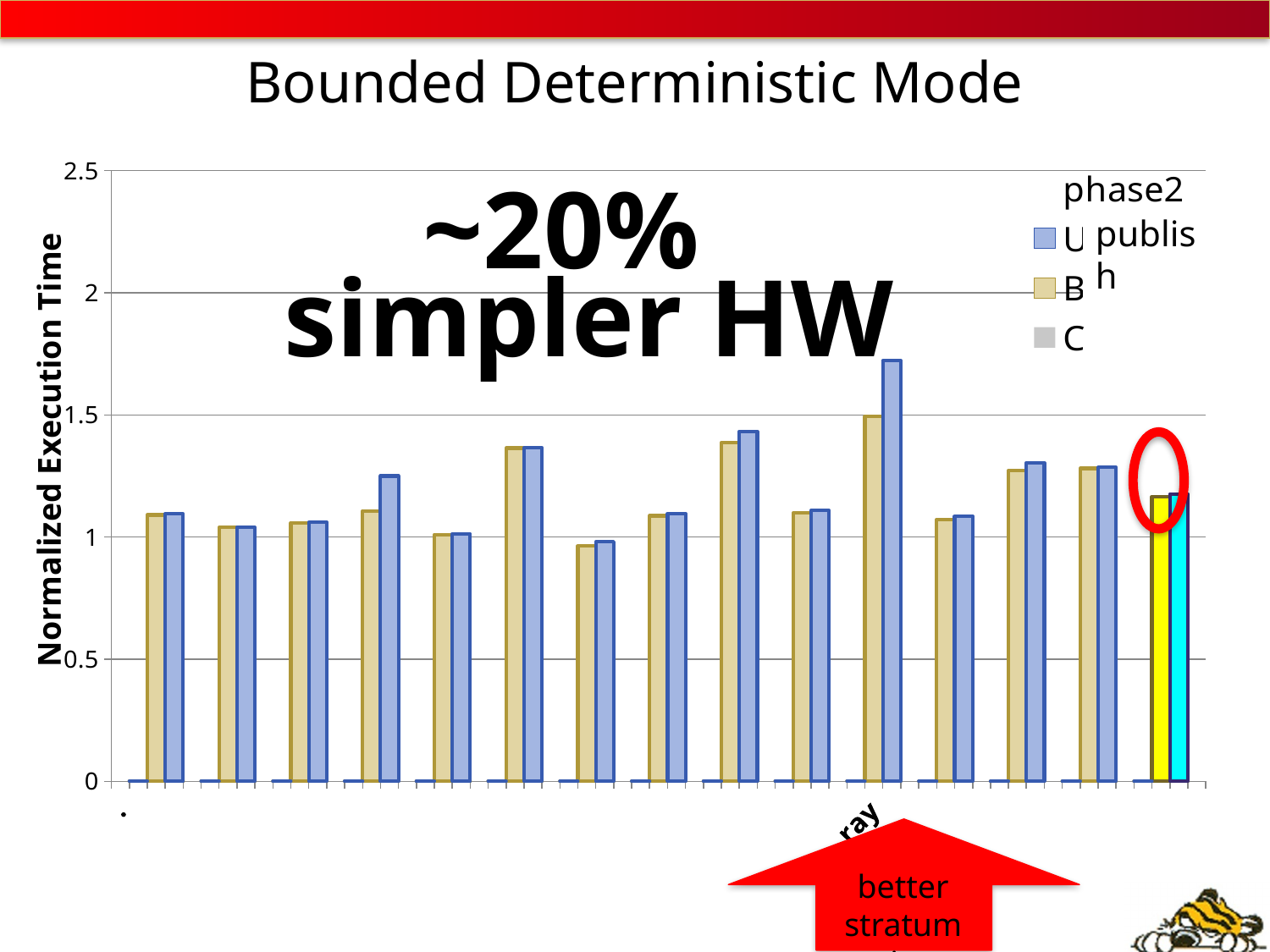
How many groups of bars are plotted along the x axis? 15 What is the title of the slide containing the chart? Bounded Deterministic Mode What kind of chart is shown on the slide? bar chart What is the label on the vertical axis of the chart? Normalized Execution Time Is the tallest bar on the chart greater or less than 1.5? greater Is the tallest bar on the chart greater or less than 2? less What is the highest tick value shown on the vertical axis? 2.5